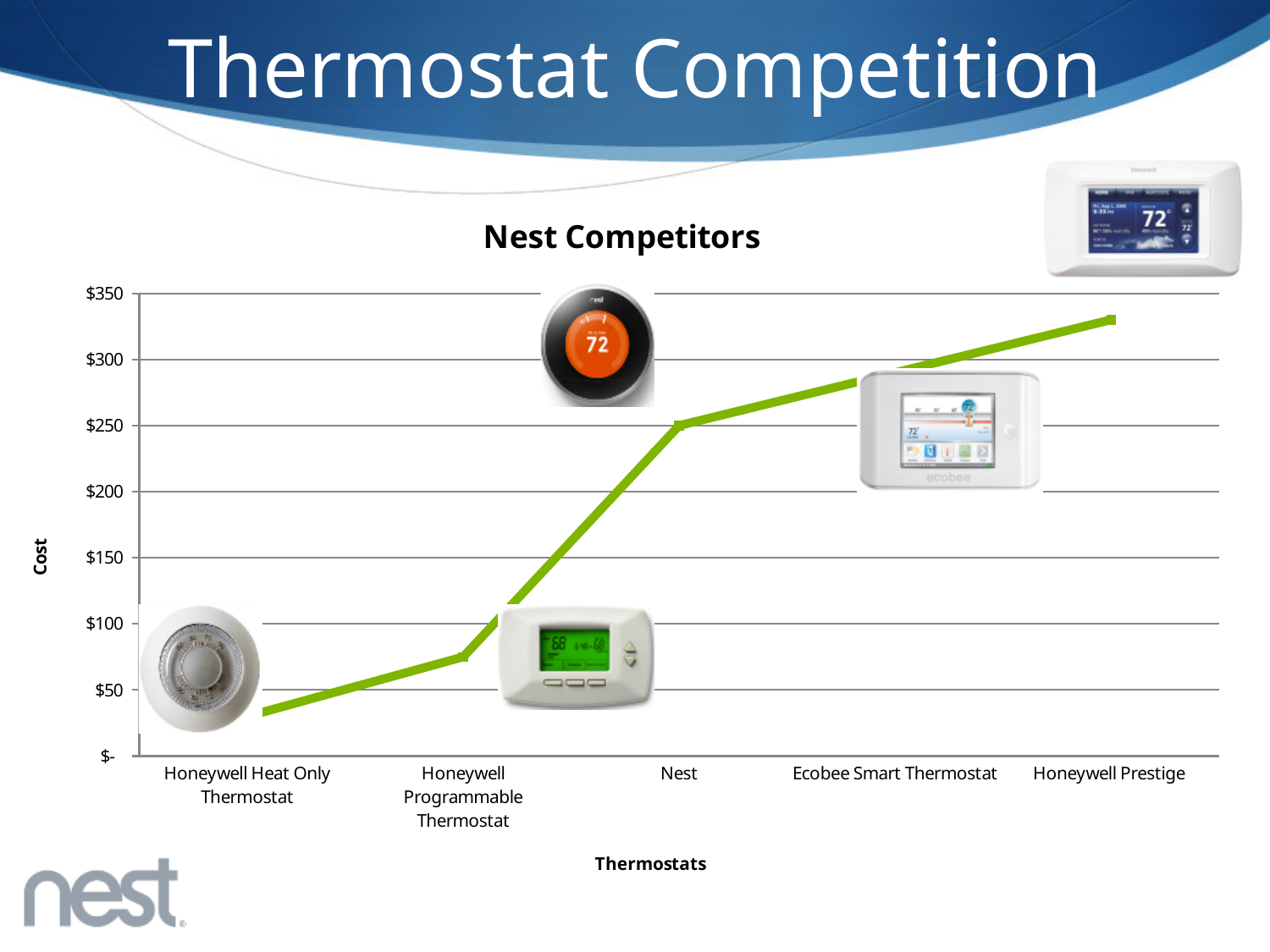
Do the cost values rise or fall moving left to right along the x axis? rise Is the cost of the Honeywell Programmable Thermostat greater or less than $100? less Which costs more, the Nest or the Honeywell Programmable Thermostat? Nest Which thermostat has the lowest cost in the chart? Honeywell Heat Only Thermostat What is the label on the vertical axis of the chart? Cost Is the cost of the Honeywell Prestige greater or less than $300? greater What kind of chart is shown on the slide? line chart What is the title of the chart? Nest Competitors How many thermostats are plotted on the x axis of the chart? 5 Is the cost of the Honeywell Heat Only Thermostat greater or less than $50? less Which thermostat has the highest cost in the chart? Honeywell Prestige